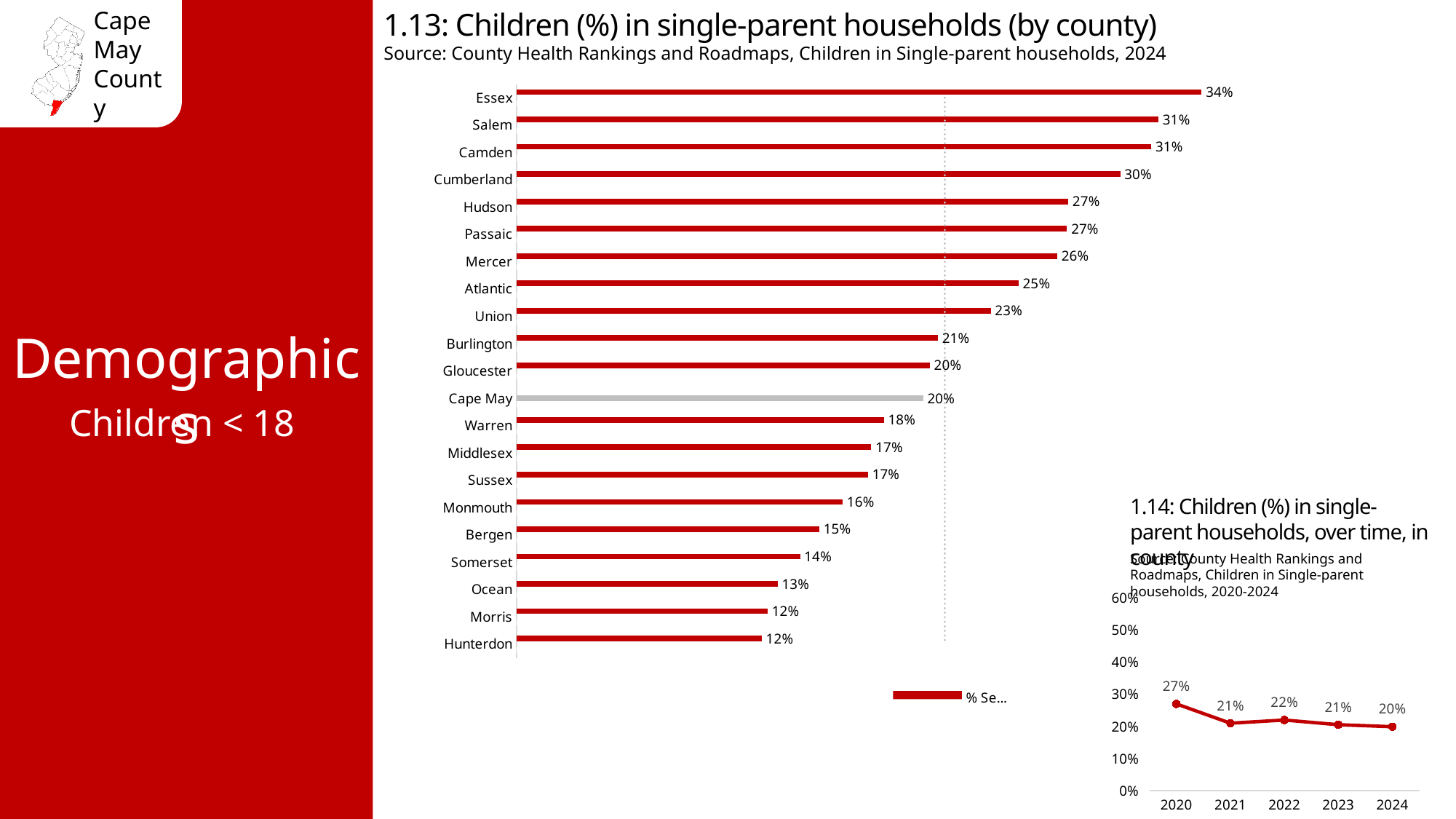
What kind of chart is chart 1.13 (Children in single-parent households by county)? Bar chart In chart 1.13 (by county), which is larger, the value for Atlantic or the value for Gloucester? Atlantic In chart 1.13 (by county), which county has the highest percentage of children in single-parent households? Essex In chart 1.14 (over time, in county), what is the difference between the 2020 and 2024 values? 7% In chart 1.13 (by county), what is the value for Essex? 34% In chart 1.14 (over time, in county), what is the value for 2020? 27% What kind of chart is chart 1.14 (Children in single-parent households over time)? Line chart In chart 1.13 (by county), what is the difference between Essex and Cape May? 14% In chart 1.13 (by county), how many counties are shown? 21 In chart 1.13 (Children in single-parent households by county), what is the value for Cape May? 20% In chart 1.13 (by county), what is the value for Cumberland? 30% In chart 1.14 (over time, in county), what is the value for 2024? 20%